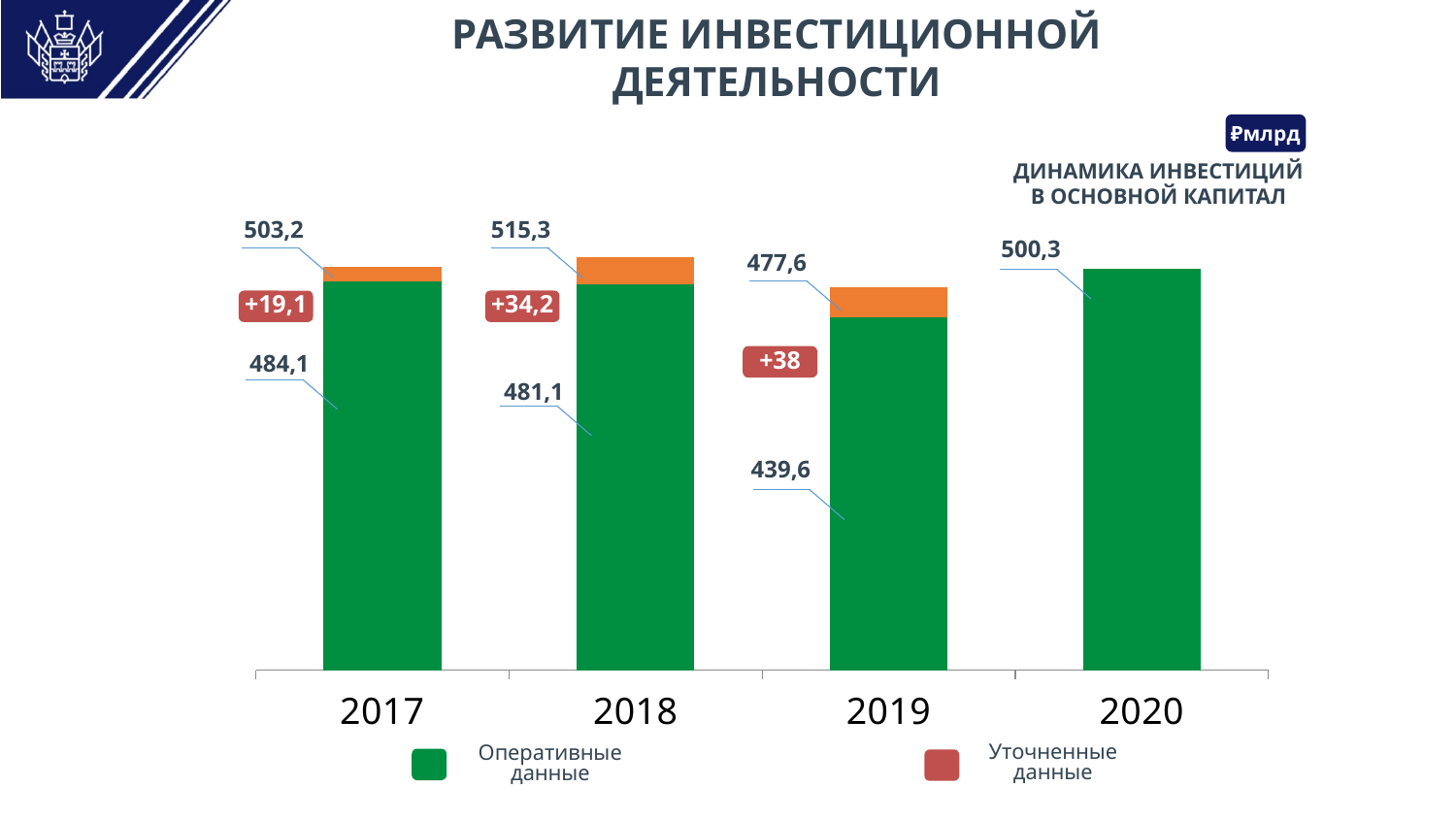
How many years are shown on the x axis? 4 Which year has the lowest operational data value? 2019 Which is larger: the operational data value for 2017 or for 2018? 2017 What is the difference between the refined total for 2018 (515,3) and the refined total for 2017 (503,2)? 12,1 What is the refined (уточненные) total value for 2018? 515,3 What kind of chart is shown on the slide? Stacked bar chart What is the operational data (Оперативные данные) value for 2017? 484,1 What is the value shown for 2020? 500,3 What is the operational data value for 2019? 439,6 What adjustment is shown for 2019? +38 Which year has the highest refined total value? 2018 How many series does the legend list? 2